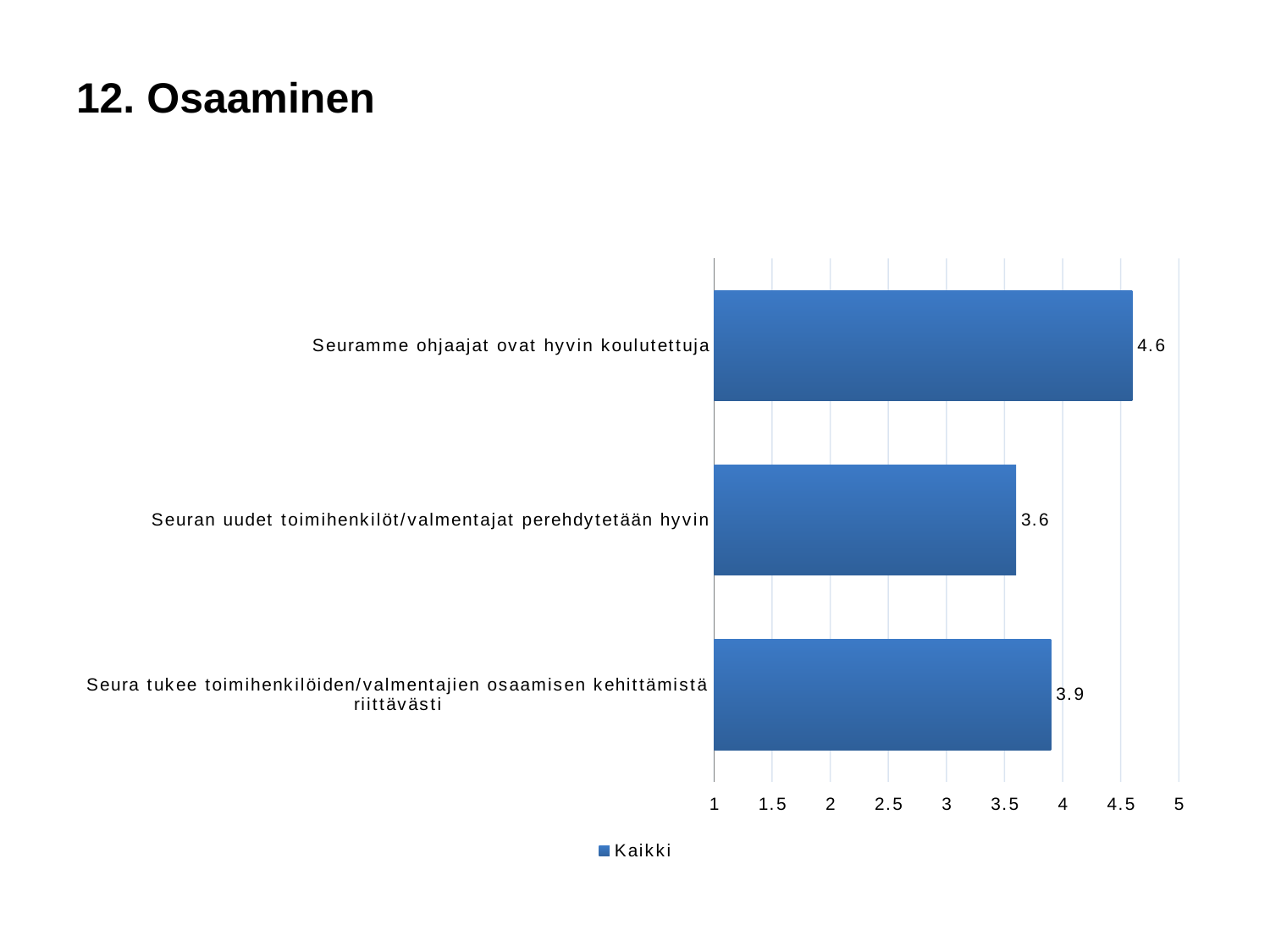
Which category has the highest value? Seuramme ohjaajat ovat hyvin koulutettuja What is the value for "Seura tukee toimihenkilöiden/valmentajien osaamisen kehittämistä riittävästi"? 3.9 How many categories are shown in the chart? 3 Which category has the lowest value? Seuran uudet toimihenkilöt/valmentajat perehdytetään hyvin Which is larger: the value for "Seura tukee toimihenkilöiden/valmentajien osaamisen kehittämistä riittävästi" or for "Seuran uudet toimihenkilöt/valmentajat perehdytetään hyvin"? Seura tukee toimihenkilöiden/valmentajien osaamisen kehittämistä riittävästi What is the difference between the values for "Seuramme ohjaajat ovat hyvin koulutettuja" and "Seuran uudet toimihenkilöt/valmentajat perehdytetään hyvin"? 1.0 What is the difference between the values for "Seura tukee toimihenkilöiden/valmentajien osaamisen kehittämistä riittävästi" and "Seuran uudet toimihenkilöt/valmentajat perehdytetään hyvin"? 0.3 What kind of chart is shown on the slide? bar chart Is the value for "Seuramme ohjaajat ovat hyvin koulutettuja" greater or less than 4? greater How many series does the legend list? 1 What is the value for "Seuran uudet toimihenkilöt/valmentajat perehdytetään hyvin"? 3.6 What is the value for "Seuramme ohjaajat ovat hyvin koulutettuja"? 4.6